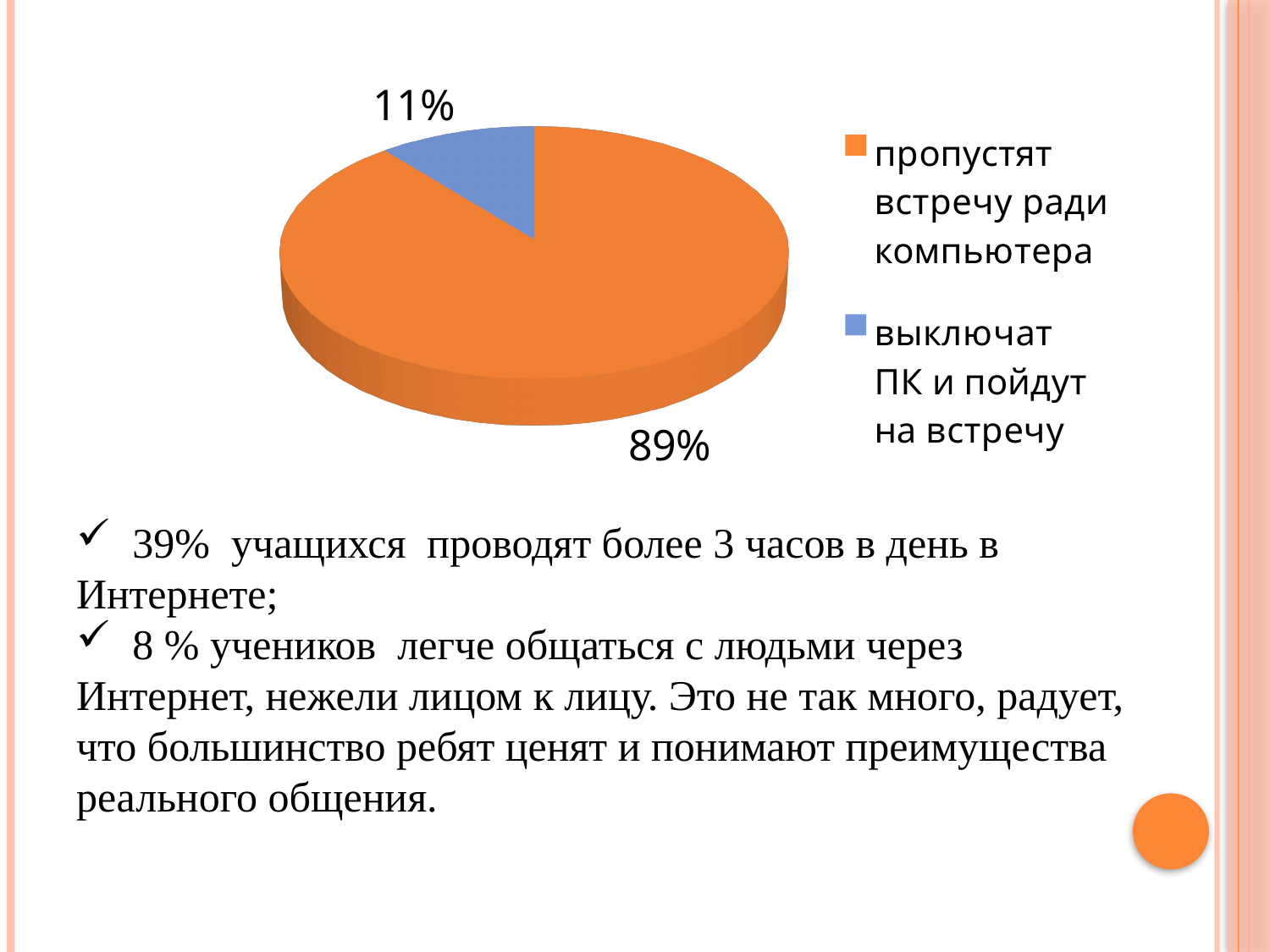
Which is larger: the slice for "пропустят встречу ради компьютера" or the slice for "выключат ПК и пойдут на встречу"? пропустят встречу ради компьютера What share of the pie does the "выключат ПК и пойдут на встречу" slice represent? 11% How many entries does the legend list? 2 How many slices does the pie chart have? 2 Which category has the largest slice of the pie? пропустят встречу ради компьютера What colour is the slice for "пропустят встречу ради компьютера"? orange What percentage of the pie is labelled "выключат ПК и пойдут на встречу"? 11% What colour is the slice for "выключат ПК и пойдут на встречу"? blue What percentage of the pie is labelled "пропустят встречу ради компьютера"? 89% Which category has the smallest slice of the pie? выключат ПК и пойдут на встречу What is the difference in percentage points between the "пропустят встречу ради компьютера" slice and the "выключат ПК и пойдут на встречу" slice? 78 What kind of chart is shown on the slide? pie chart